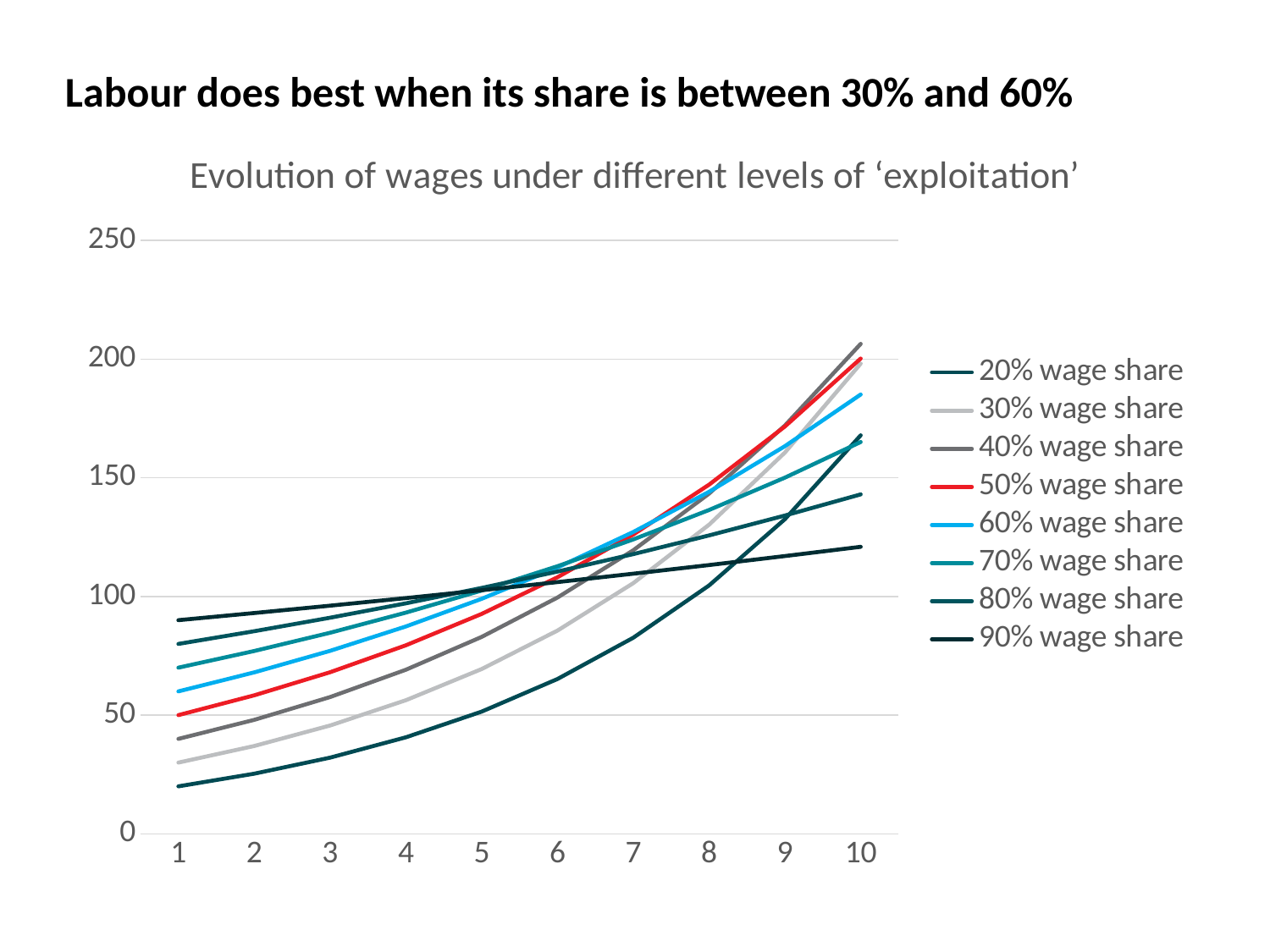
Is the value for 80% wage share at x = 10 greater or less than 150? less What is the title of the chart? Evolution of wages under different levels of 'exploitation' How many series does the legend list? 8 Is the value for 90% wage share at x = 10 greater or less than 100? greater At x = 10, which is larger: 60% wage share or 90% wage share? 60% wage share Does the 20% wage share series rise or fall from x = 1 to x = 10? rise What kind of chart is shown on the slide? line chart Is the value for 20% wage share at x = 1 greater or less than 50? less Which series has the lowest value at x = 10? 90% wage share How many points are plotted along the x axis for each series? 10 Which series has the highest value at x = 1? 90% wage share Which series has the lowest value at x = 1? 20% wage share